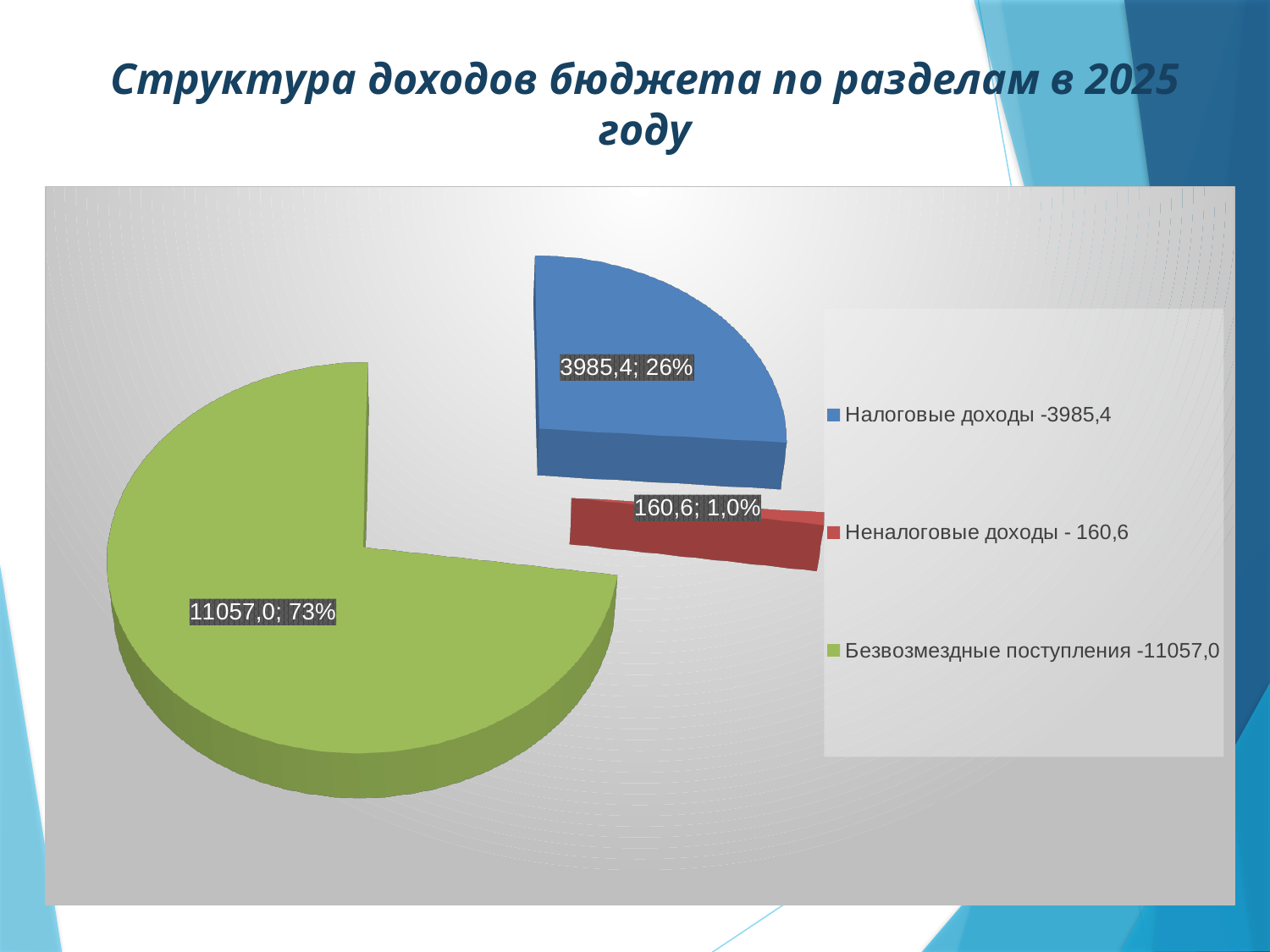
What share of the pie does Налоговые доходы represent? 26% What is the difference between the values for Безвозмездные поступления and Налоговые доходы? 7071,6 What is the value for Неналоговые доходы? 160,6 What type of chart is shown on the slide? Pie chart Which category has the smallest slice? Неналоговые доходы What share of the pie does Безвозмездные поступления represent? 73% How many categories does the pie chart have? 3 What is the value for Безвозмездные поступления? 11057,0 What share of the pie does Неналоговые доходы represent? 1,0% Which category has the largest slice? Безвозмездные поступления What is the value for Налоговые доходы? 3985,4 What colour is the slice for Неналоговые доходы? Red